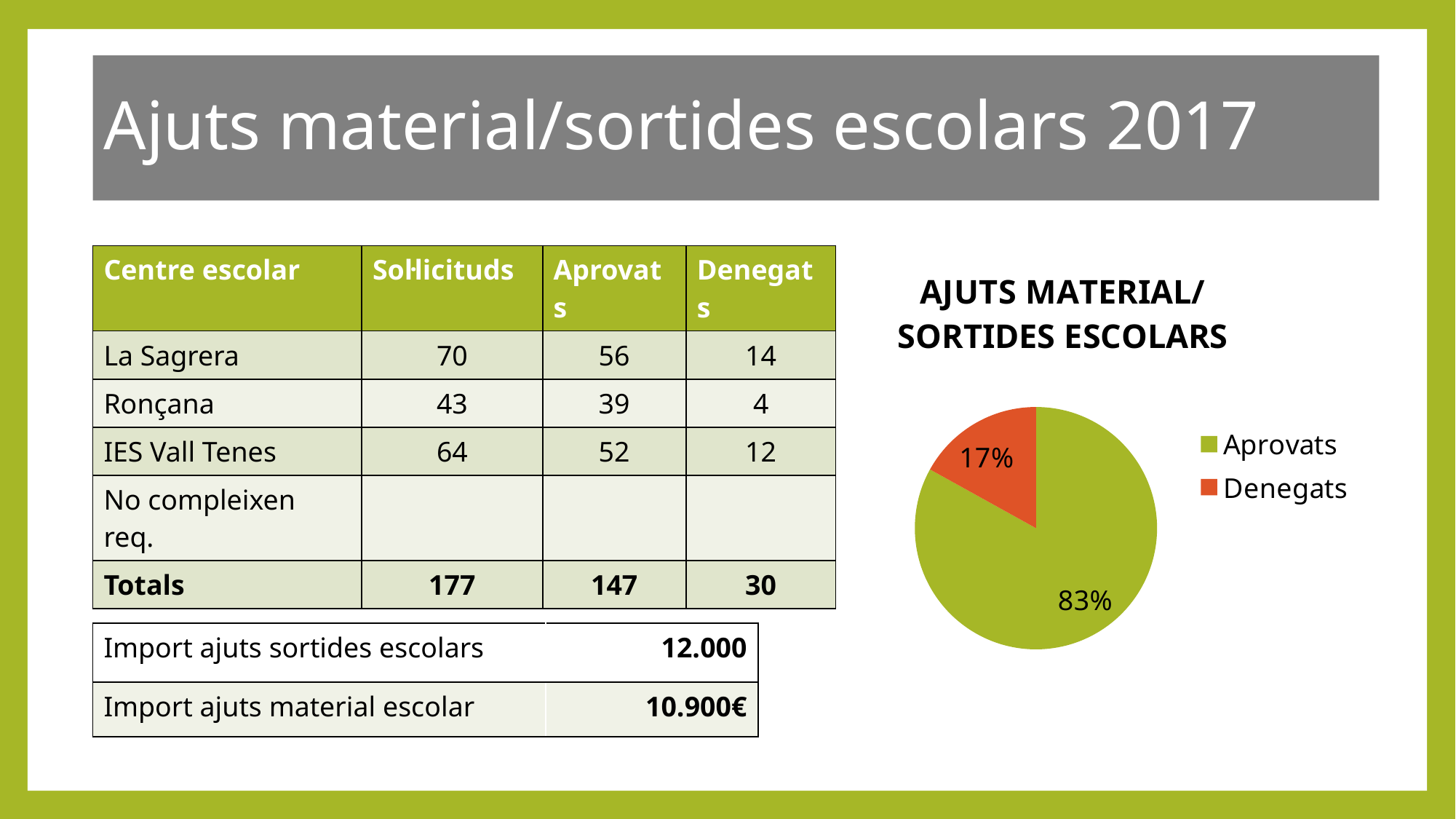
How many slices does the pie chart have? 2 Is the share for Aprovats greater or less than 50%? greater What is the title of the pie chart? AJUTS MATERIAL/ SORTIDES ESCOLARS What share of the pie chart is Aprovats? 83% Which is larger in the pie chart, Aprovats or Denegats? Aprovats How many entries does the pie chart legend list? 2 What kind of chart is shown on the slide? pie chart Which slice of the pie chart is the smallest? Denegats Which slice of the pie chart is the largest? Aprovats What share of the pie chart is Denegats? 17% What is the difference in percentage points between the Aprovats and Denegats slices? 66 What colour is the Denegats slice in the pie chart? orange-red